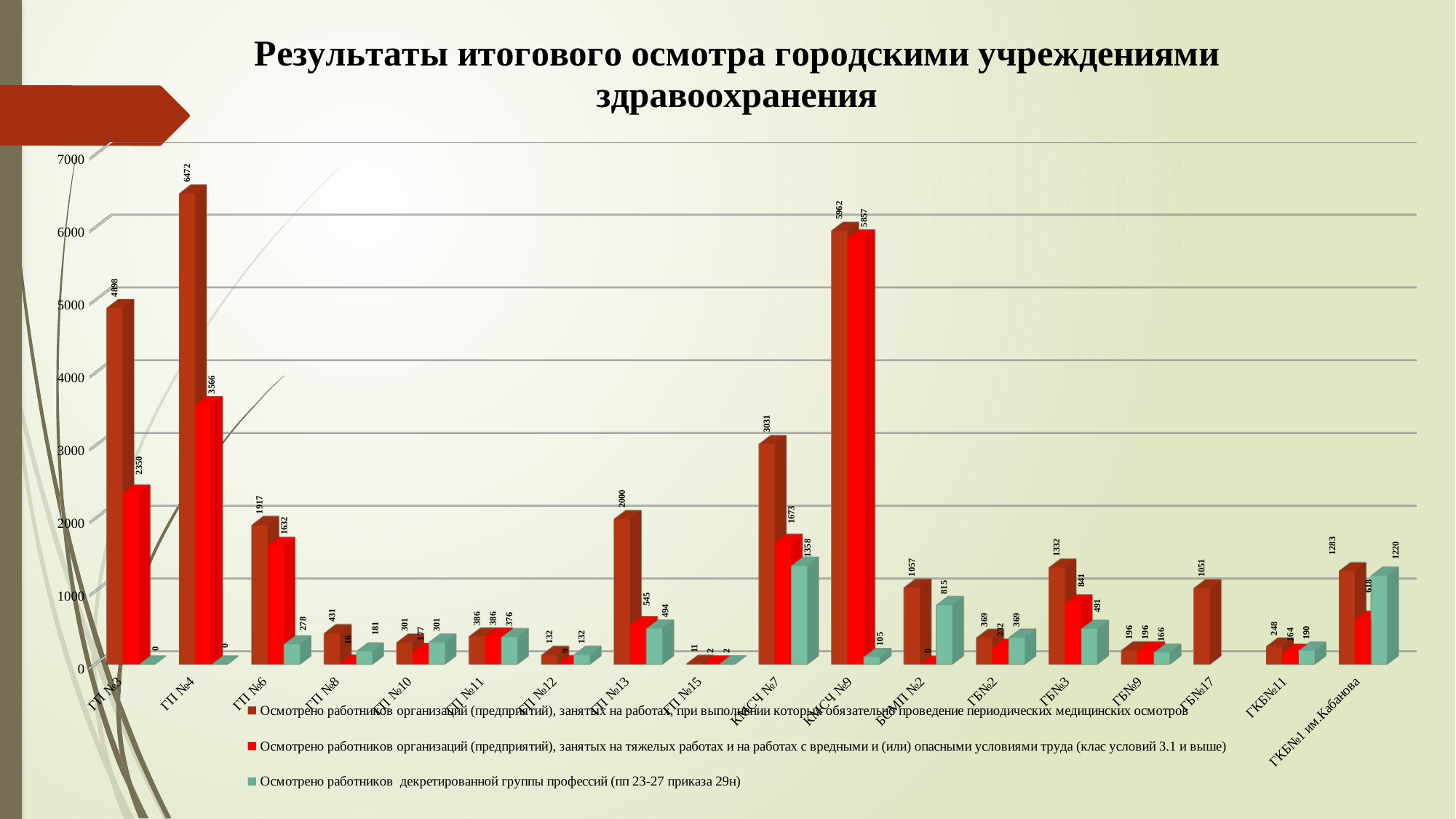
What is the value of the teal series (decreed group of professions) for ГКБ№1 им.Кабанова? 1220 How many series does the legend list? 3 Which institution has the highest value in the teal series (decreed group of professions)? КМСЧ №7 What is the value of the red series (workers in heavy/hazardous conditions, class 3.1 and above) for КМСЧ №9? 5857 What type of chart is shown on the slide? bar chart What is the title of the chart? Результаты итогового осмотра городскими учреждениями здравоохранения Is the dark red series value for ГП №13 greater or less than 1000? greater What is the difference between the dark red and red series values for ГП №3? 2548 Which is larger for КМСЧ №7: the red series value or the teal series value? the red series (1673) What is the value of the dark red series (workers examined for mandatory periodic medical examinations) for ГП №4? 6472 How many institutions (categories) are shown on the x axis? 18 Which institution has the highest value in the dark red series (mandatory periodic medical examinations)? ГП №4